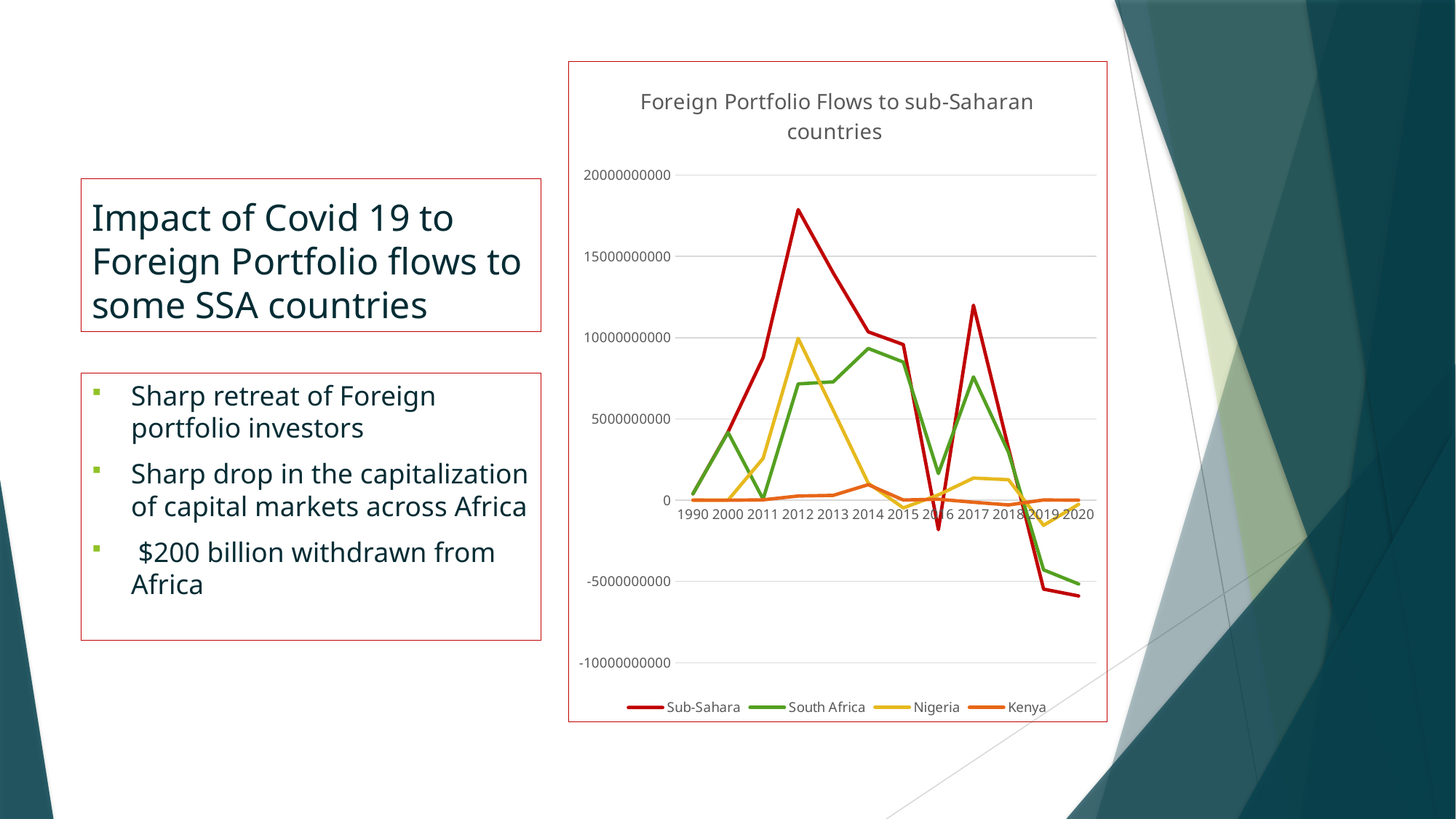
Is the value for Sub-Sahara in 2017 greater or less than 10000000000? greater Which series is drawn in red in the chart? Sub-Sahara Is the value for Sub-Sahara in 2012 greater or less than 15000000000? greater Does the Sub-Sahara series rise or fall from 2017 to 2020? fall Is the value for Nigeria in 2012 greater or less than 5000000000? greater In 2012, which is larger: the value for Sub-Sahara or the value for South Africa? Sub-Sahara What is the title of the chart? Foreign Portfolio Flows to sub-Saharan countries In which year does the Sub-Sahara series reach its highest value? 2012 What kind of chart is shown on the slide? line chart Which series reaches the highest value anywhere in the chart? Sub-Sahara How many years are shown on the x axis of the chart? 12 How many series does the legend of the chart list? 4